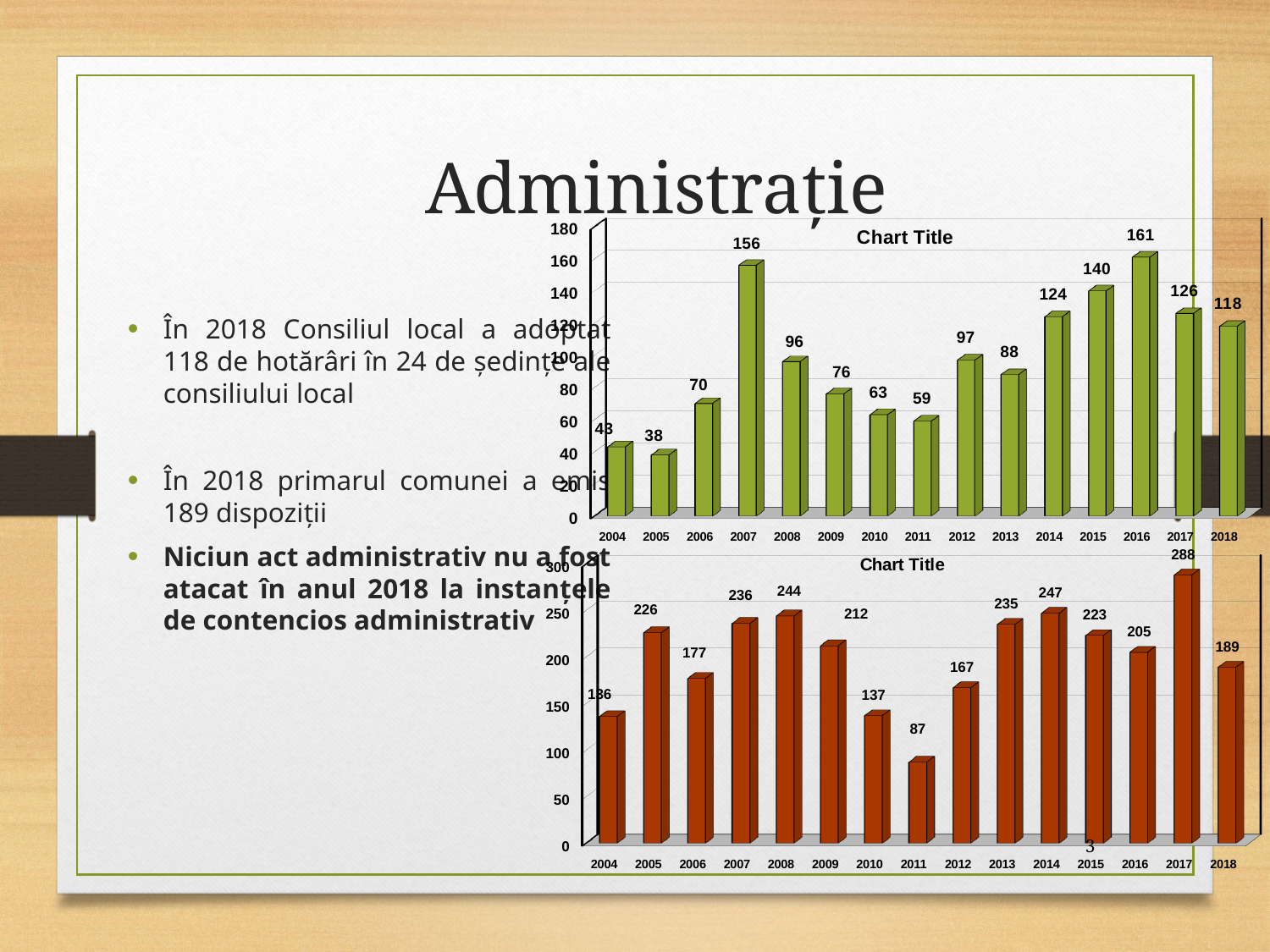
How many years are shown on the x axis of the top chart? 15 In the top chart, which year has the lowest value? 2005 In the bottom chart, what is the difference between the values for 2017 and 2011? 201 In the top chart, what is the difference between the values for 2016 and 2018? 43 In the bottom chart, which year has the lowest value? 2011 What type of chart is the bottom chart? bar chart In the top chart, what is the value for 2012? 97 In the bottom chart, what is the value for 2018? 189 In the bottom chart, which year has the highest value? 2017 In the top chart, which year has the highest value? 2016 In the top chart, what is the value for 2007? 156 In the bottom chart, which year has the larger value, 2008 or 2013? 2008